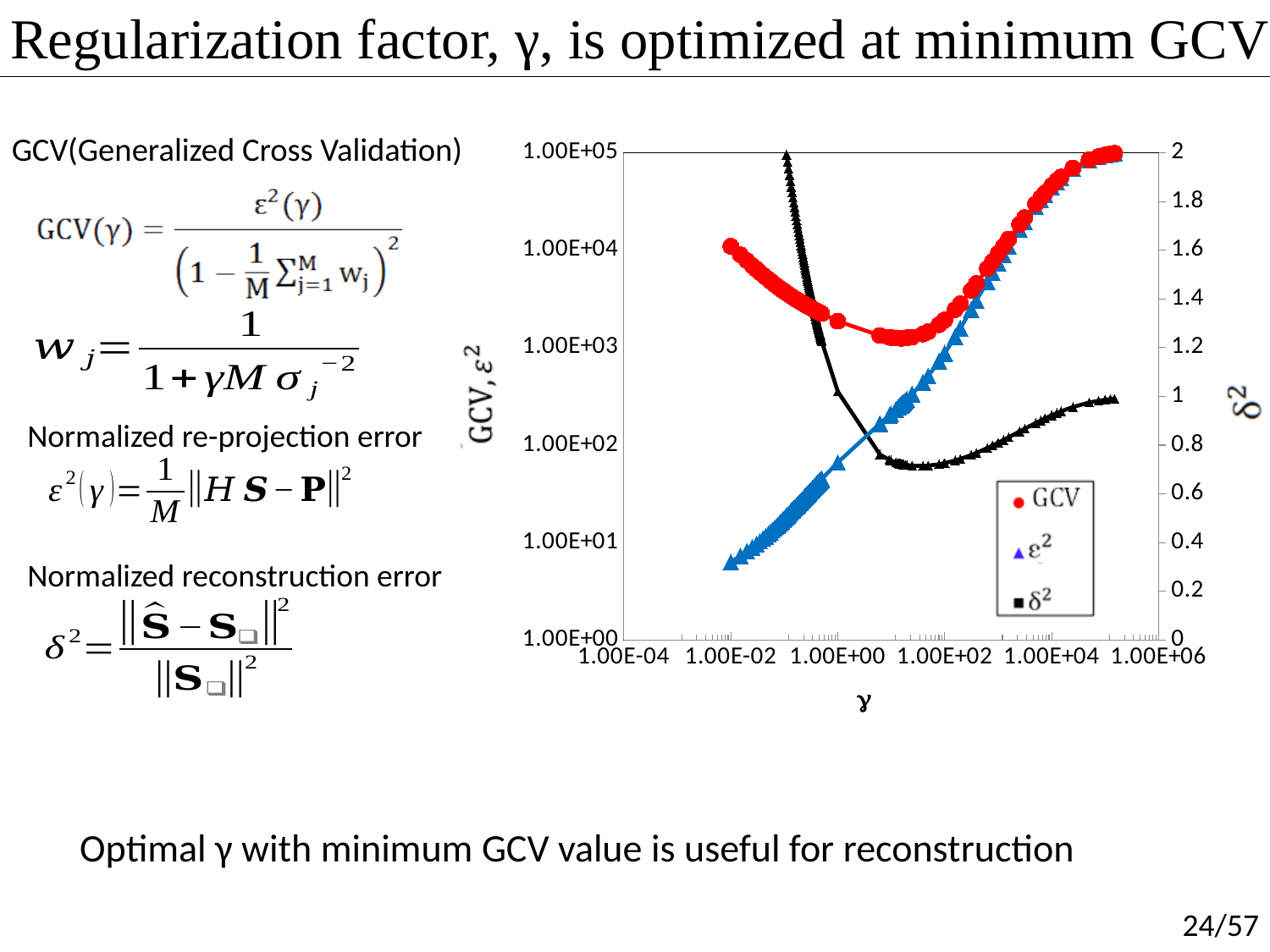
At γ = 1.00E-02, which series has the larger value on the left axis, GCV or ε²? GCV Does the GCV series first fall and then rise, or first rise and then fall, as γ increases? first falls, then rises What kind of chart is shown on the slide? scatter (line) chart What is the maximum value shown on the right-hand (δ²) axis? 2 Is the minimum value of the δ² series greater or less than 1 on the right axis? less Is the δ² value at the left end of its curve greater or less than 1.5 on the right axis? greater Which series is plotted against the right-hand (secondary) axis? δ² Is the minimum value of the GCV series greater or less than 1.00E+04? less What are the three series named in the chart legend? GCV, ε², δ² How many series does the chart legend list? 3 Does the ε² series rise or fall as γ increases along the x axis? rises